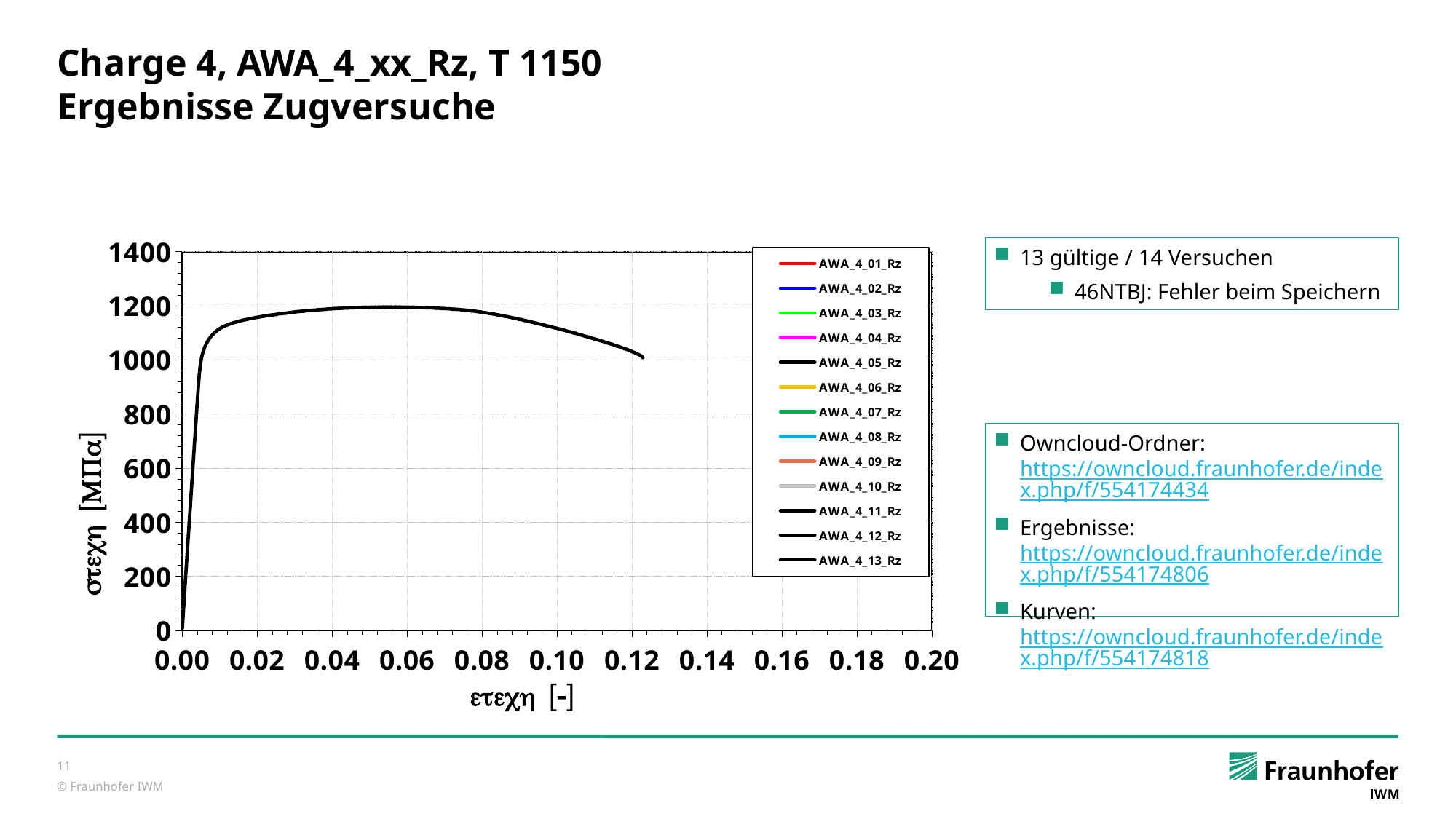
How many series does the chart legend list? 13 Is the peak stress value of the plotted curve greater or less than 1000? greater Is the stress value at a strain of 0.12 greater or less than 1200? less Is the stress value at a strain of 0.02 greater or less than 1000? greater Between strain 0.06 and strain 0.12, does the plotted curve rise or fall? fall What is the first entry in the chart legend? AWA_4_01_Rz What kind of chart is shown on the slide? line chart What is the highest tick value shown on the x axis? 0.20 What colour is the legend line for AWA_4_01_Rz? red Between strain 0.00 and strain 0.02, does the plotted curve rise or fall? rise